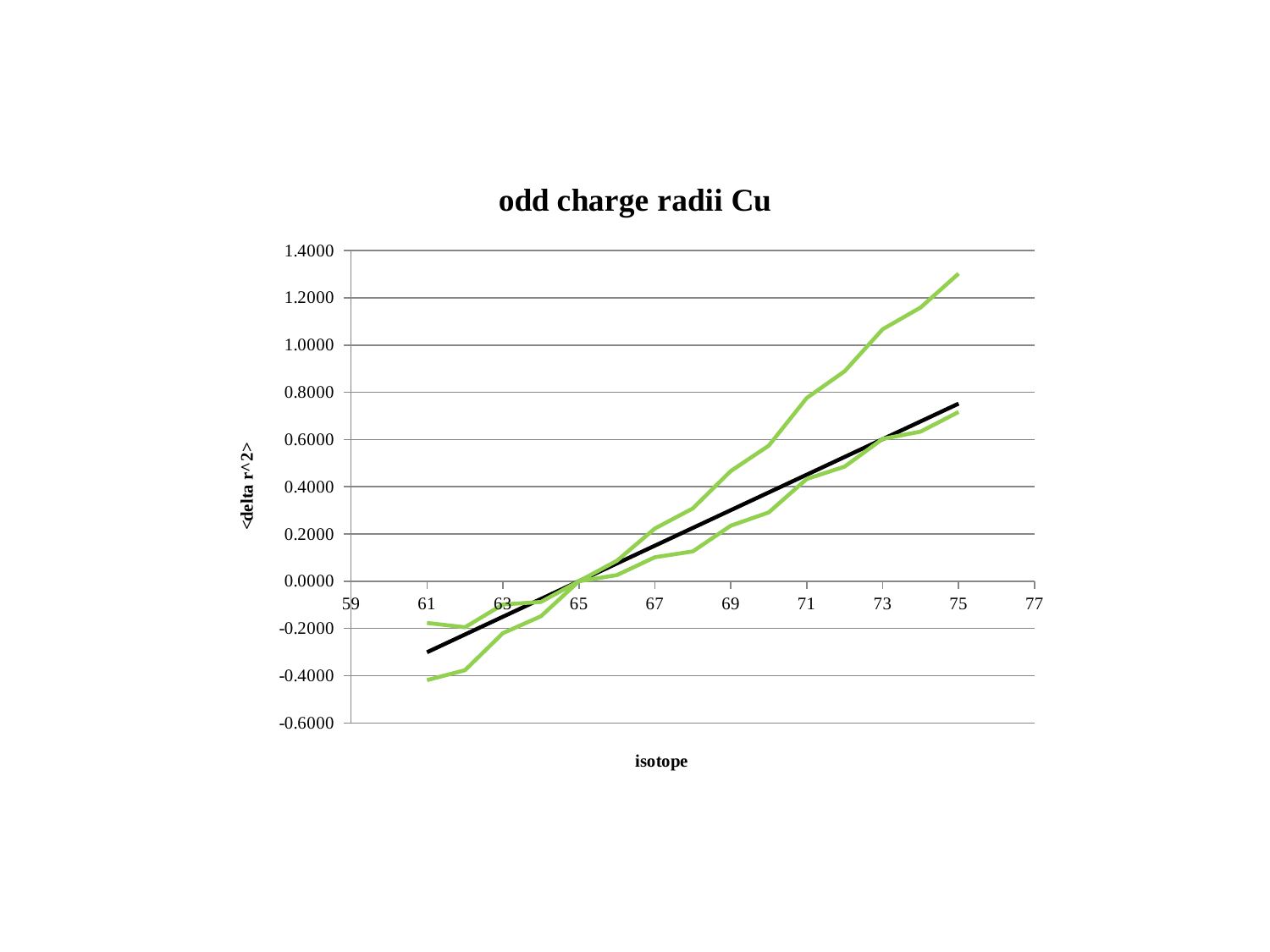
Do the plotted lines rise or fall as the isotope number increases along the x axis? rise Is the value of the upper green line at isotope 71 greater or less than 0.6000? greater Is the value of the black line at isotope 61 greater or less than -0.2000? less Is the value of the black line at isotope 75 greater or less than 0.6000? greater How many lines are plotted on the chart? 3 At isotope 75, which line has the larger value, the upper green line or the black line? the upper green line What kind of chart is shown on the slide? line chart What is the label on the vertical axis of the chart? <delta r^2> What is the title of the chart? odd charge radii Cu